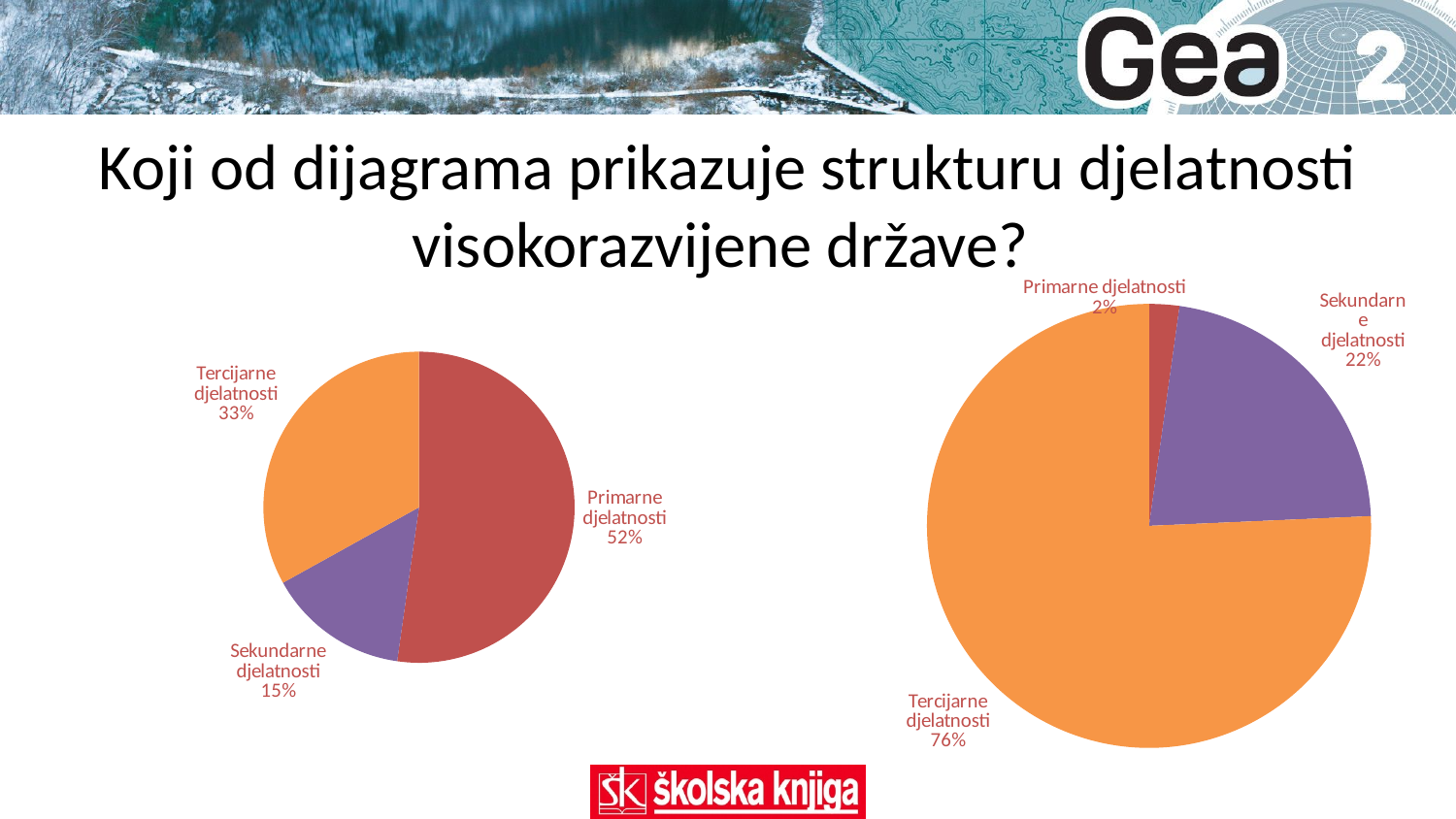
In the right pie chart, what share is shown for Sekundarne djelatnosti? 22% In the right pie chart, what share is shown for Tercijarne djelatnosti? 76% How many slices does the left pie chart have? 3 In the left pie chart, what share is shown for Primarne djelatnosti? 52% In the left pie chart, what share is shown for Sekundarne djelatnosti? 15% In the left pie chart, which category has the largest slice? Primarne djelatnosti In the left pie chart, which is larger: Tercijarne djelatnosti or Sekundarne djelatnosti? Tercijarne djelatnosti In the right pie chart, what share is shown for Primarne djelatnosti? 2% In the right pie chart, which category has the smallest slice? Primarne djelatnosti In the right pie chart, what is the difference between the shares of Tercijarne djelatnosti and Sekundarne djelatnosti? 54% What type of chart is shown on the right side of the slide? Pie chart In the left pie chart, what share is shown for Tercijarne djelatnosti? 33%